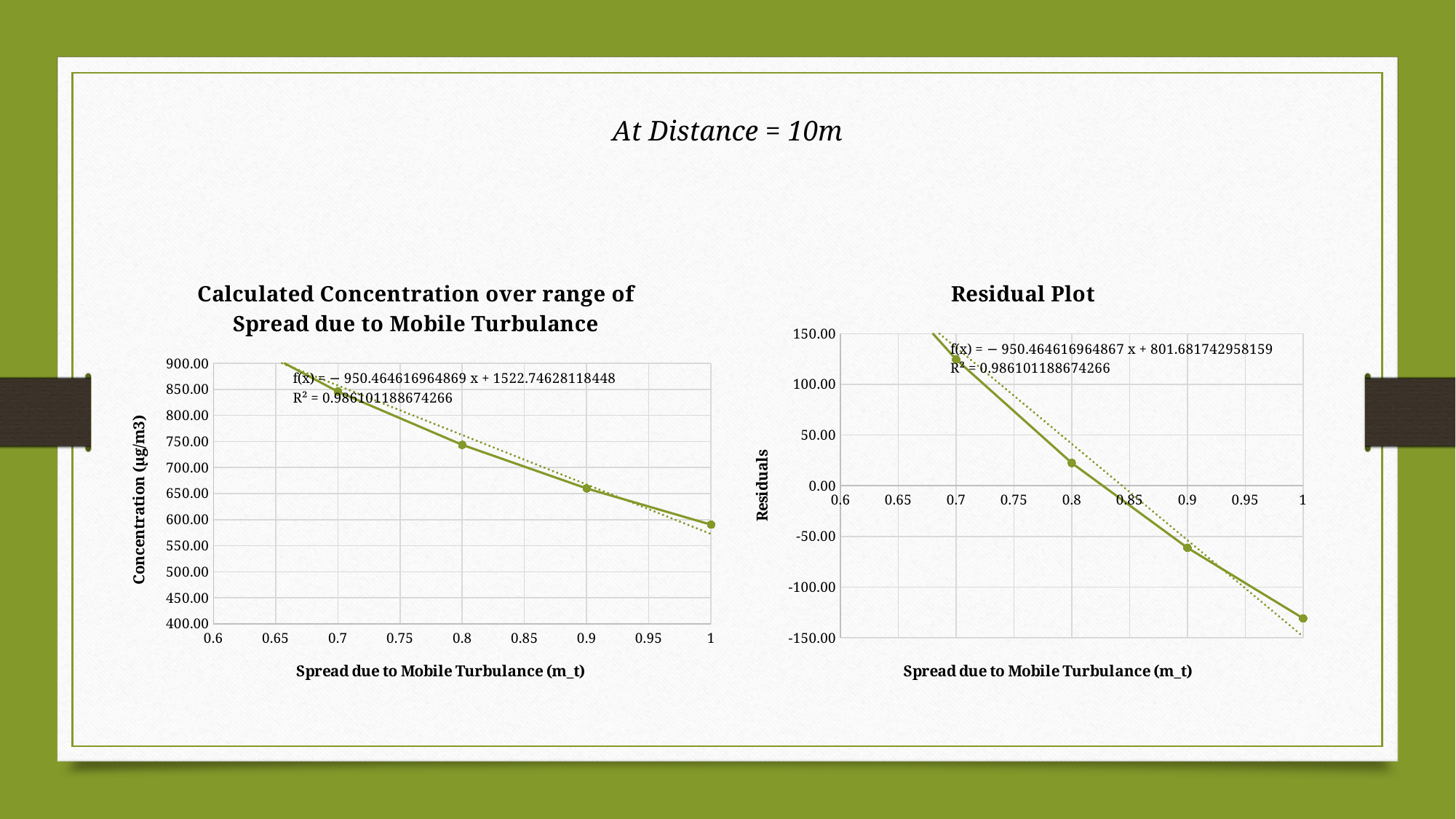
In the chart titled "Calculated Concentration over range of Spread due to Mobile Turbulance", is the concentration at a spread of 0.7 greater or less than 800.00? greater In the chart titled "Calculated Concentration over range of Spread due to Mobile Turbulance", is the concentration at a spread of 1 greater or less than 600.00? less In the chart titled "Calculated Concentration over range of Spread due to Mobile Turbulance", at which spread value is the concentration highest? 0.7 In the chart titled "Residual Plot", which has the larger residual: a spread of 0.8 or a spread of 0.9? 0.8 In the chart titled "Residual Plot", at which spread value is the residual lowest? 1 In the chart titled "Calculated Concentration over range of Spread due to Mobile Turbulance", how many data points are plotted? 4 In the chart titled "Residual Plot", is the residual at a spread of 0.7 greater or less than 100.00? greater In the chart titled "Residual Plot", do the residuals rise or fall as the spread increases along the x axis? fall What R² value is shown on the chart titled "Residual Plot"? 0.986101188674266 In the chart titled "Residual Plot", how many data points are plotted? 4 In the chart titled "Calculated Concentration over range of Spread due to Mobile Turbulance", do the values rise or fall as the spread increases along the x axis? fall